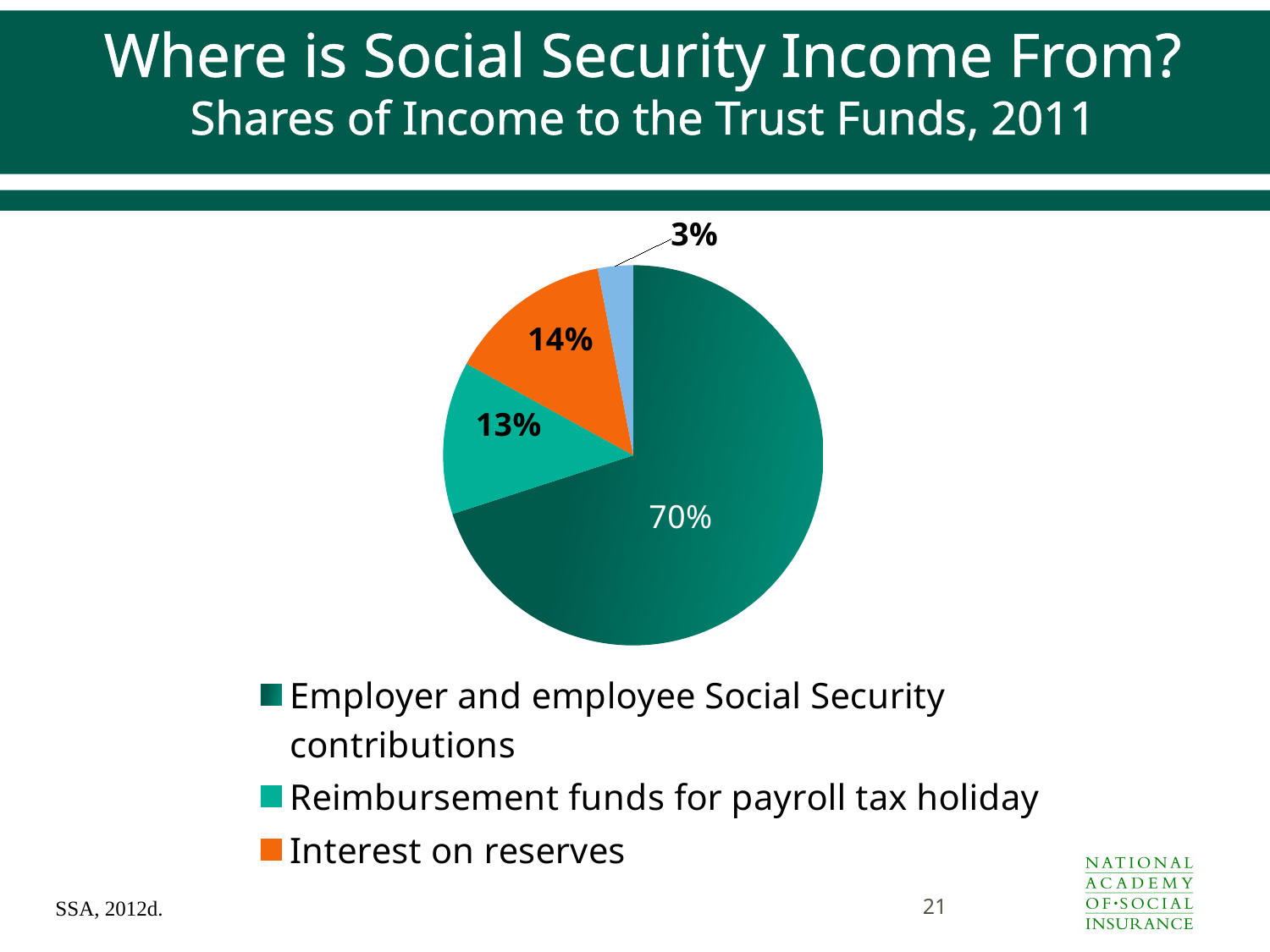
How many slices does the pie chart have? 4 Which source accounts for the largest share of income to the trust funds? Employer and employee Social Security contributions Which is larger: the share from interest on reserves or the share from reimbursement funds for the payroll tax holiday? Interest on reserves What kind of chart is shown on the slide? Pie chart What is the smallest percentage shown on the pie chart? 3% How many entries does the legend list? 3 What is the difference in percentage points between the share from employer and employee contributions and the share from interest on reserves? 56 percentage points What share of income to the trust funds came from employer and employee Social Security contributions? 70% What colour is the slice representing interest on reserves? Orange What share of income came from interest on reserves? 14% What is the combined share of reimbursement funds for the payroll tax holiday and interest on reserves? 27% What share of income came from reimbursement funds for the payroll tax holiday? 13%